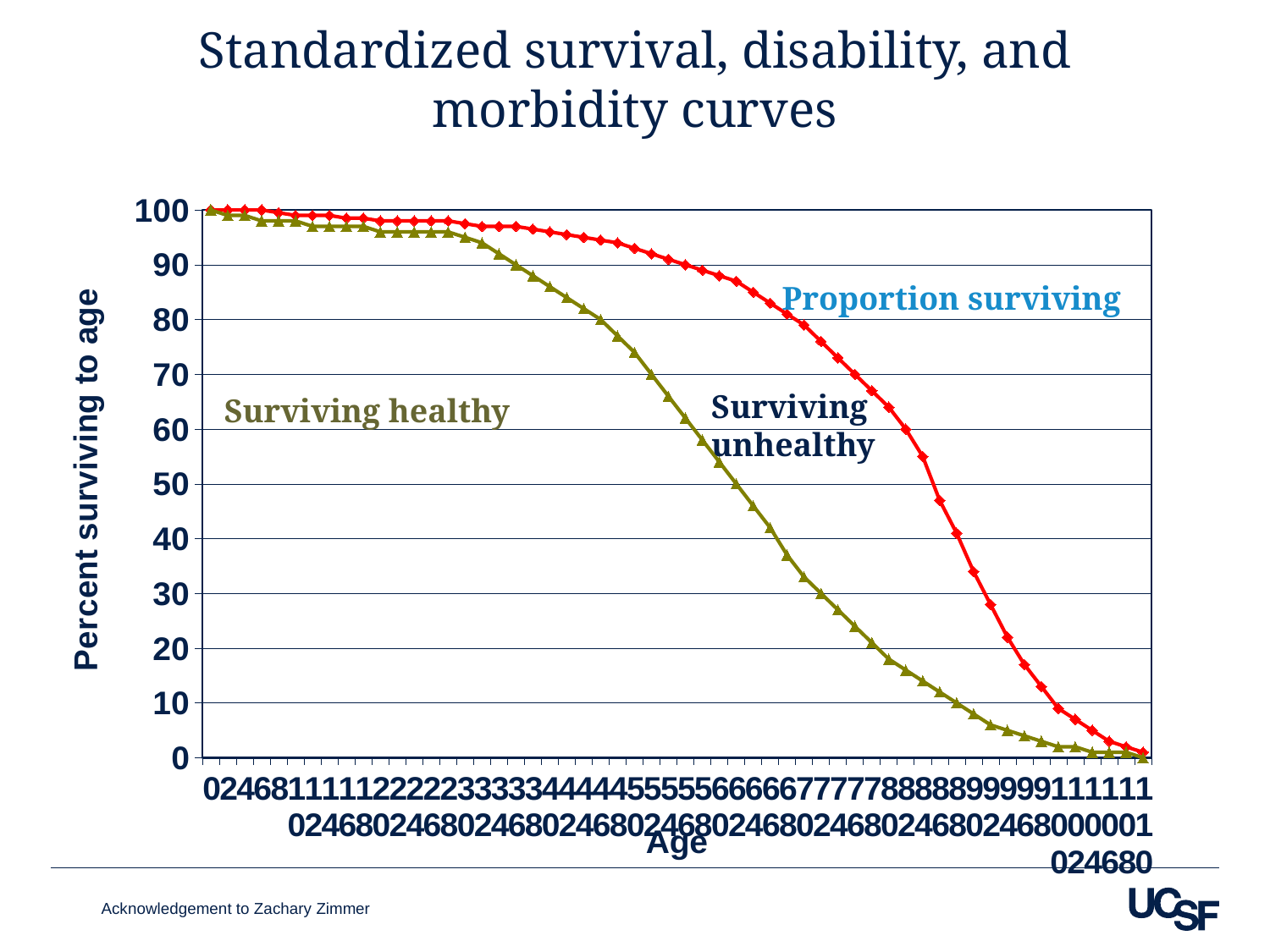
Does the Surviving healthy curve ever rise above the Proportion surviving curve? No Do the plotted values rise or fall as age increases along the x axis? fall At the right end of the chart, is the Surviving healthy value greater or less than 10? less At the right end of the chart, is the Proportion surviving value greater or less than 10? less What is the title of the chart on the slide? Standardized survival, disability, and morbidity curves Which curve is higher across the chart, Proportion surviving or Surviving healthy? Proportion surviving Which curve drops below 50 percent first as age increases, Proportion surviving or Surviving healthy? Surviving healthy At the left end of the chart, is the Surviving healthy value greater or less than 90? greater How many data series (curves) are plotted on the chart? 2 What is the value of the Proportion surviving curve at age 0? 100 What type of chart is shown on the slide? line chart What label is given to the red curve? Proportion surviving